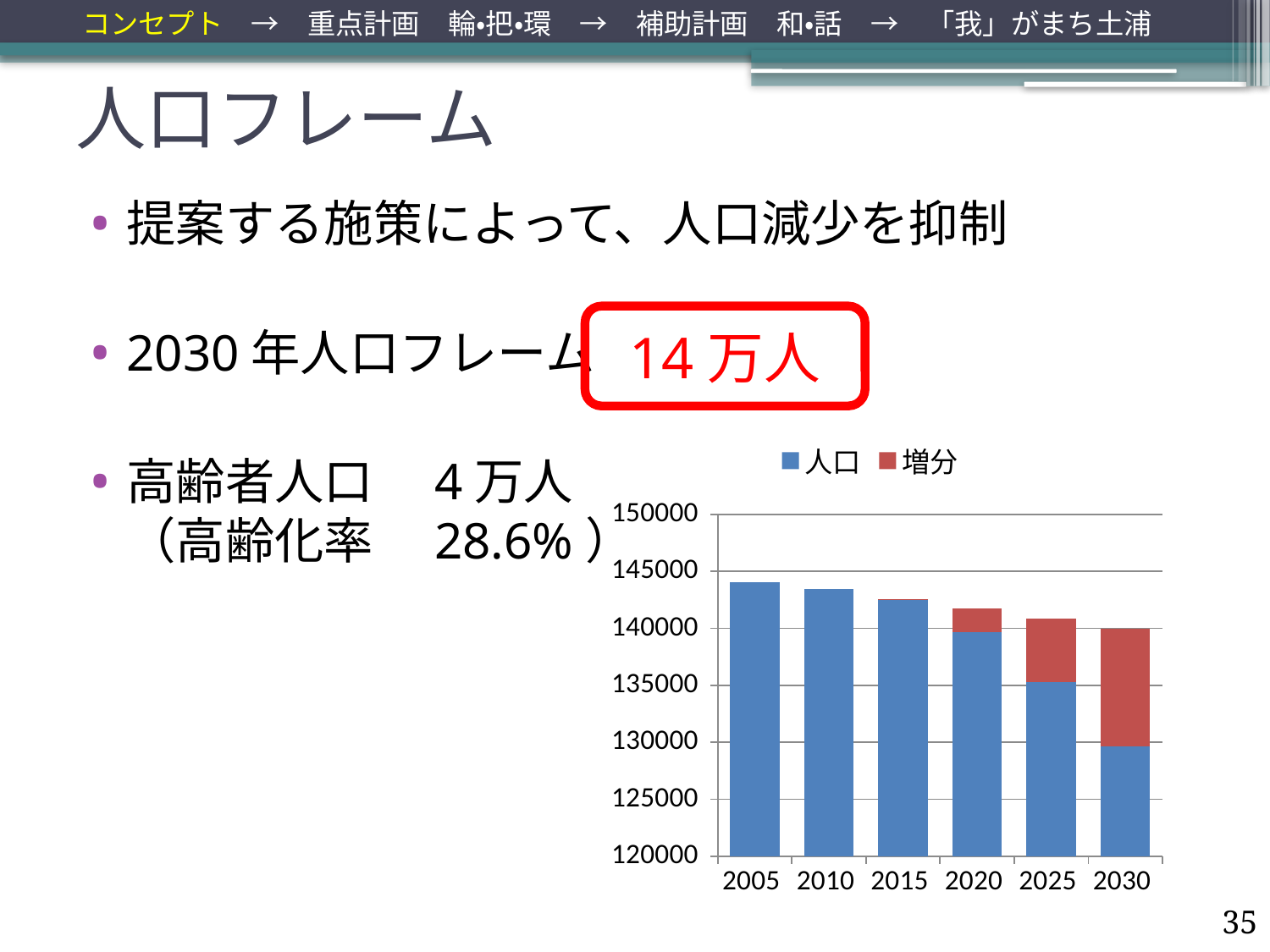
Does the 人口 series rise or fall from 2005 to 2030? Fall Which year has the larger 増分 segment, 2025 or 2030? 2030 Which year has the highest 人口 value in the chart? 2005 What kind of chart is shown on the slide? Stacked bar chart Which colour represents the 増分 series in the chart? Red Is the 人口 value for 2030 greater or less than 135000? less Is the 人口 value for 2025 greater or less than 140000? less What are the two series named in the chart legend? 人口 and 増分 Is the 人口 value for 2005 greater or less than 140000? greater How many years are shown on the x axis of the chart? 6 Which year has the lowest 人口 value in the chart? 2030 How many series does the chart legend list? 2